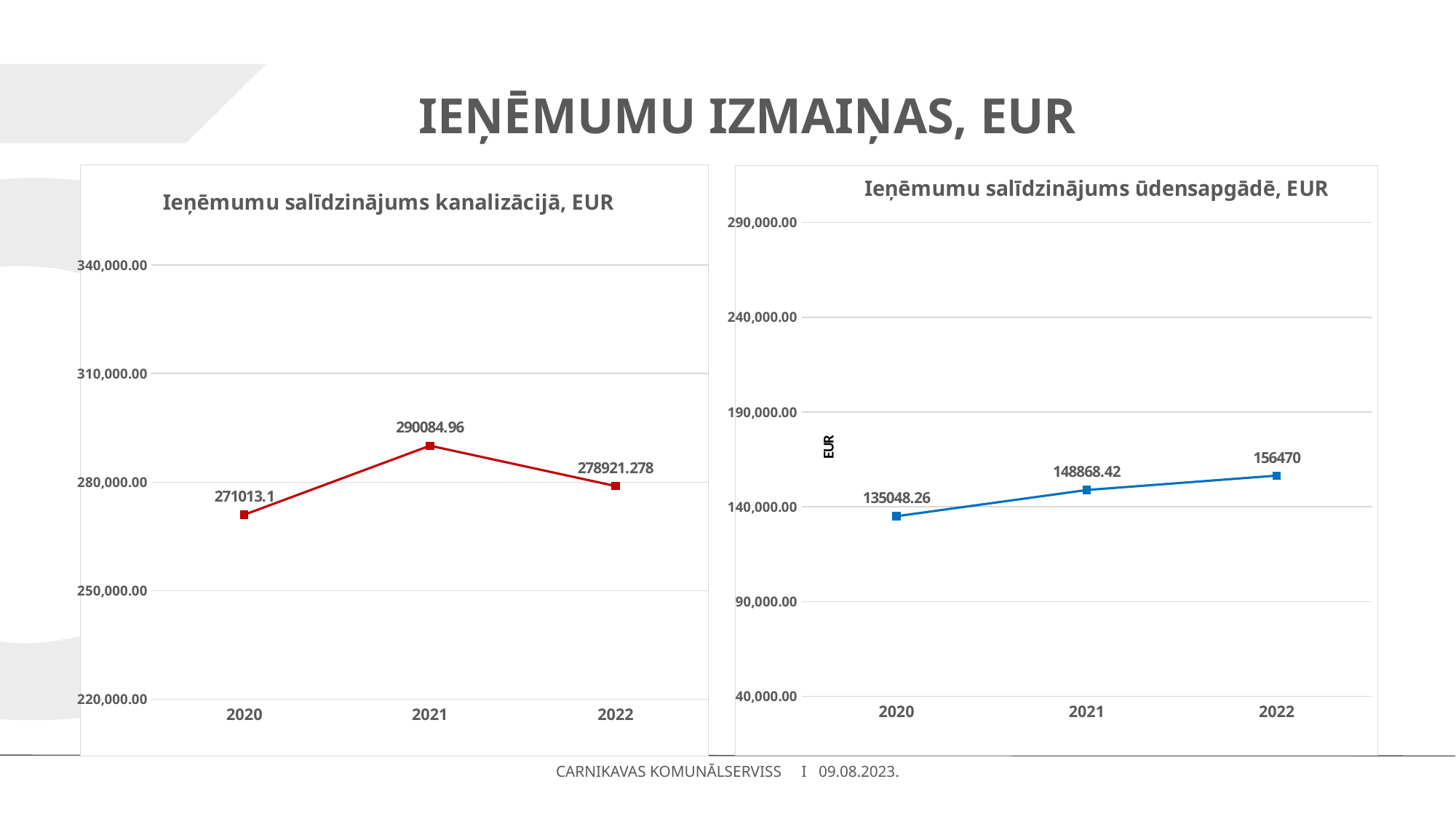
In the chart 'Ieņēmumu salīdzinājums kanalizācijā, EUR', what is the value for 2020? 271013.1 In the chart 'Ieņēmumu salīdzinājums kanalizācijā, EUR', is the value for 2022 greater or less than 280,000.00? less In the chart 'Ieņēmumu salīdzinājums ūdensapgādē, EUR', do the values rise or fall from 2020 to 2022? rise In the chart 'Ieņēmumu salīdzinājums kanalizācijā, EUR', which year has the highest value? 2021 How many years are plotted in the chart 'Ieņēmumu salīdzinājums kanalizācijā, EUR'? 3 In the chart 'Ieņēmumu salīdzinājums ūdensapgādē, EUR', what is the value for 2020? 135048.26 In the chart 'Ieņēmumu salīdzinājums kanalizācijā, EUR', what is the difference between the 2021 and 2020 values? 19071.86 In the chart 'Ieņēmumu salīdzinājums ūdensapgādē, EUR', which year has the lowest value? 2020 In the chart 'Ieņēmumu salīdzinājums ūdensapgādē, EUR', what is the difference between the 2022 and 2021 values? 7601.58 In the chart 'Ieņēmumu salīdzinājums ūdensapgādē, EUR', what is the value for 2022? 156470 In the chart 'Ieņēmumu salīdzinājums kanalizācijā, EUR', what is the value for 2021? 290084.96 What kind of chart is 'Ieņēmumu salīdzinājums ūdensapgādē, EUR'? line chart